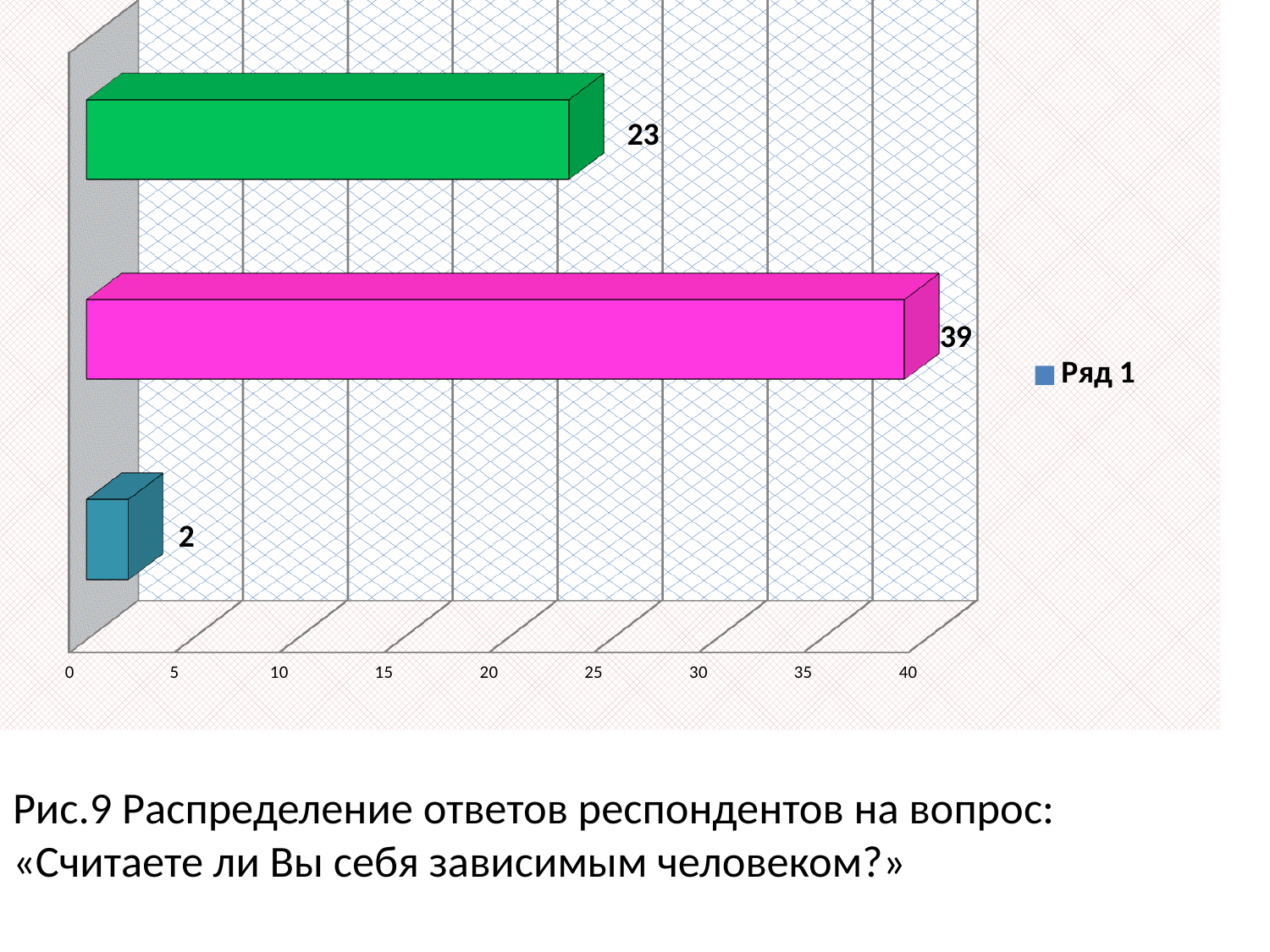
What type of chart is shown on the slide? bar chart Which is larger, the value of the green bar or the value of the blue bar? green bar How many series does the legend list? 1 What is the value shown on the green bar? 23 Which bar has the lowest value: the green, magenta or blue one? blue What is the value shown on the magenta (pink) bar? 39 What is the name of the series shown in the legend? Ряд 1 What is the difference between the magenta bar's value and the green bar's value? 16 What is the value shown on the small blue bar at the bottom? 2 How many bars are plotted in the chart? 3 Which bar has the highest value: the green, magenta or blue one? magenta What is the difference between the green bar's value and the blue bar's value? 21